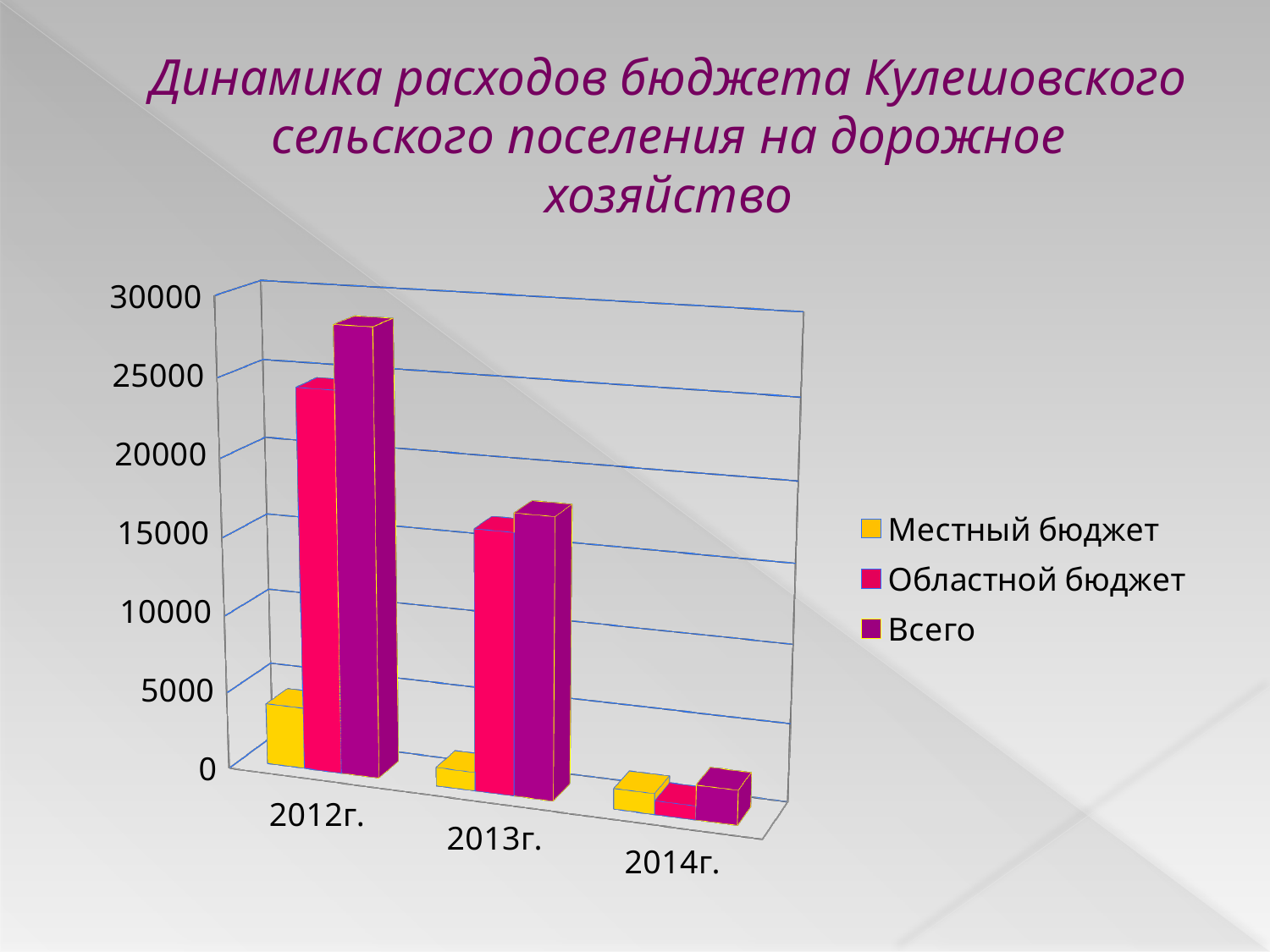
Is the value for Всего in 2013г. greater or less than 20000? less Is the value for Местный бюджет in 2012г. greater or less than 5000? less How many year categories are shown on the x axis? 3 In which year is the value for Всего the highest? 2012г. How many series does the legend list? 3 What kind of chart is shown on the slide? bar chart In which year is the value for Всего the lowest? 2014г. Is the value for Всего in 2012г. greater or less than 25000? greater Does the value for Всего rise or fall from 2012г. to 2014г.? fall Which series is shown in yellow in the legend? Местный бюджет Which is larger in 2012г., Местный бюджет or Областной бюджет? Областной бюджет